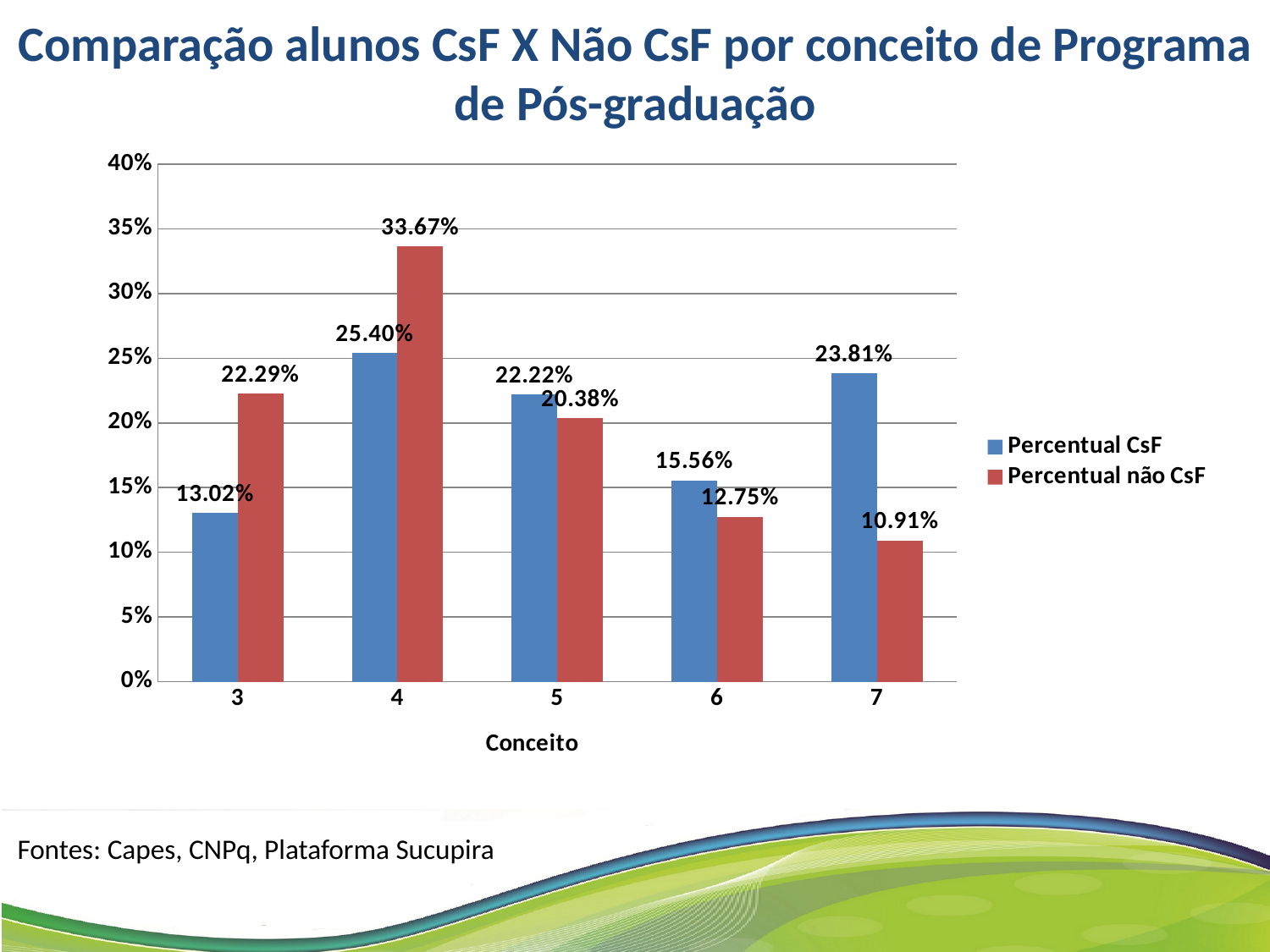
What is the Percentual não CsF value for Conceito 7? 10.91% What is the label of the x axis? Conceito How many Conceito categories are shown on the x axis? 5 For Conceito 7, which is larger: Percentual CsF or Percentual não CsF? Percentual CsF What is the difference between Percentual não CsF and Percentual CsF for Conceito 3? 9.27% Which Conceito has the highest Percentual não CsF value? 4 Which Conceito has the lowest Percentual CsF value? 3 Is the Percentual não CsF value for Conceito 4 greater or less than 30%? greater What kind of chart is shown on the slide? Bar chart What is the Percentual CsF value for Conceito 4? 25.40% What is the Percentual CsF value for Conceito 6? 15.56% How many series does the legend list? 2